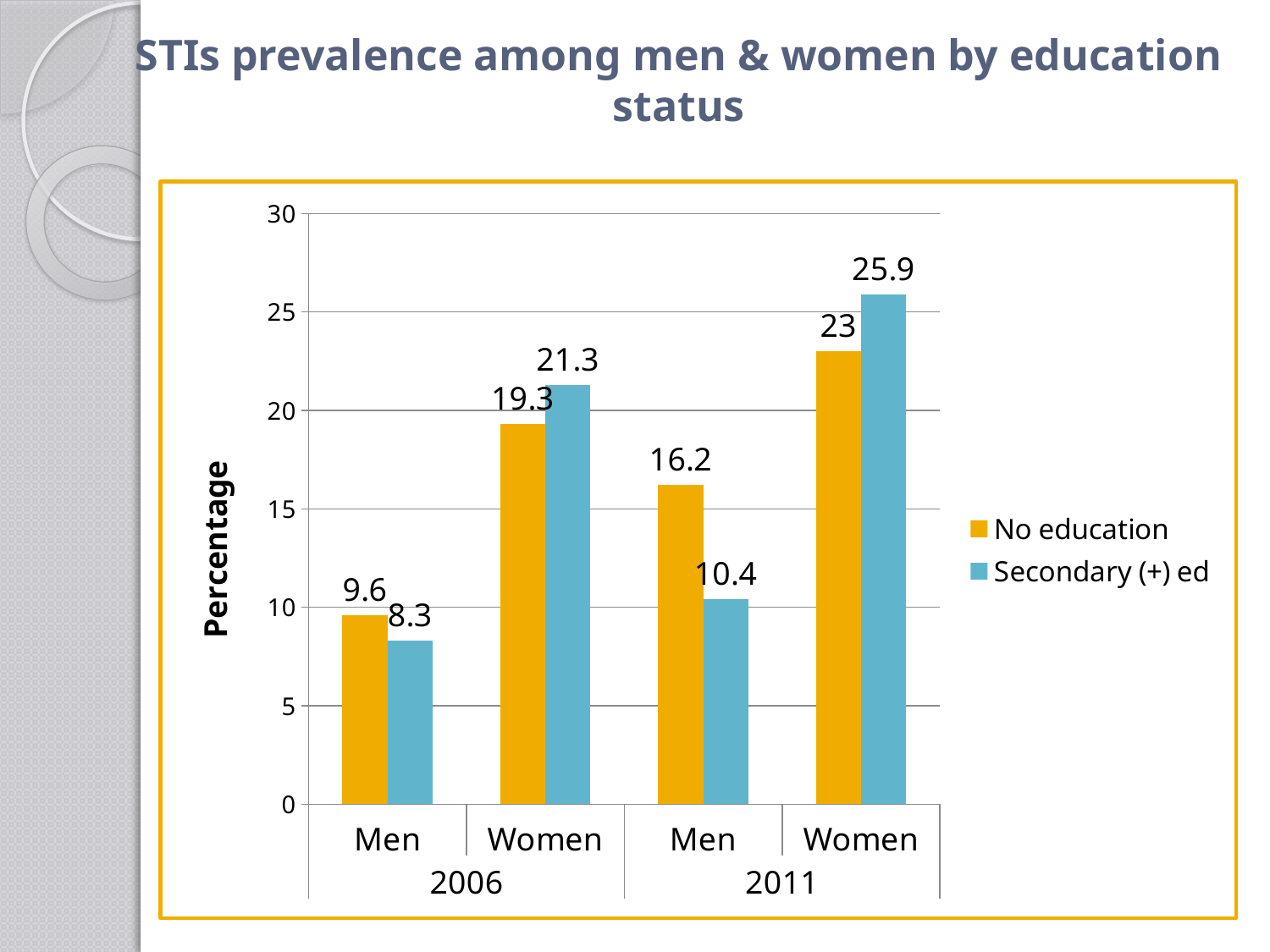
What is the difference between the Secondary (+) ed and No education values for Women in 2006? 2 What kind of chart is shown on the slide? Bar chart How many series does the legend list? 2 Which category has the highest value for the No education series? Women 2011 What is the value for Secondary (+) ed among Women in 2011? 25.9 What is the value for Secondary (+) ed among Men in 2011? 10.4 How many categories are shown on the x axis? 4 For Men in 2006, which is larger: No education or Secondary (+) ed? No education What is the difference between the No education and Secondary (+) ed values for Men in 2011? 5.8 What is the value for No education among Men in 2006? 9.6 Which category has the lowest value for the Secondary (+) ed series? Men 2006 What is the label of the y axis? Percentage